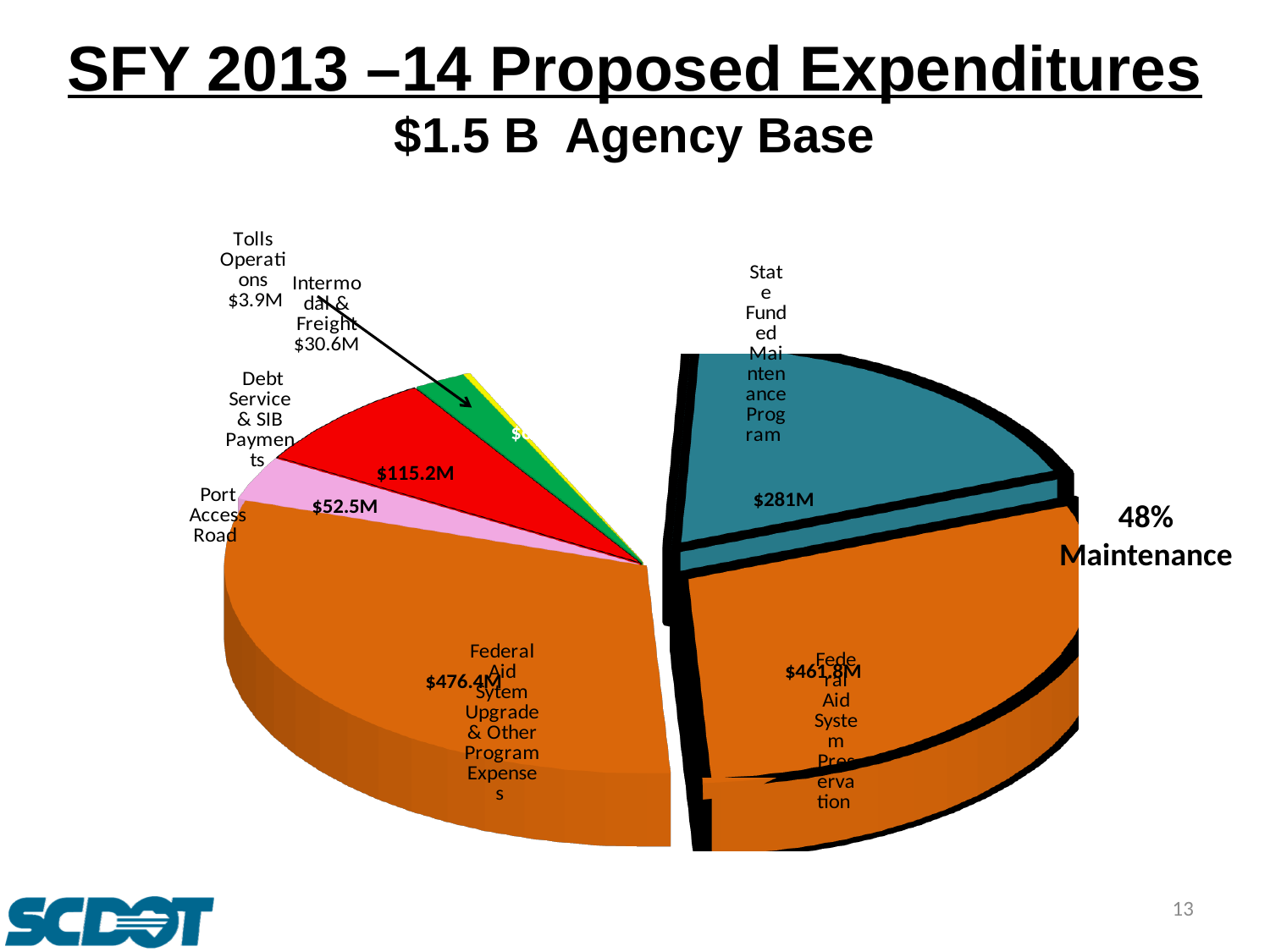
Which is larger, the State Funded Maintenance Program value or the Federal Aid System Preservation value? Federal Aid System Preservation What is the difference between the Debt Service & SIB Payments value and the Port Access Road value? $62.7M What is the value for Intermodal & Freight? $30.6M What is the value for Port Access Road? $52.5M What is the value for the State Funded Maintenance Program slice? $281M What percentage is labelled as Maintenance on the slide? 48% What kind of chart is shown on the slide? Pie chart Which category has the largest value in the pie chart? Federal Aid System Upgrade & Other Program Expenses What is the value for the Federal Aid System Upgrade & Other Program Expenses slice? $476.4M Which category has the smallest value in the pie chart? Tolls Operations What is the value for Debt Service & SIB Payments? $115.2M What is the value for the Federal Aid System Preservation slice? $461.8M